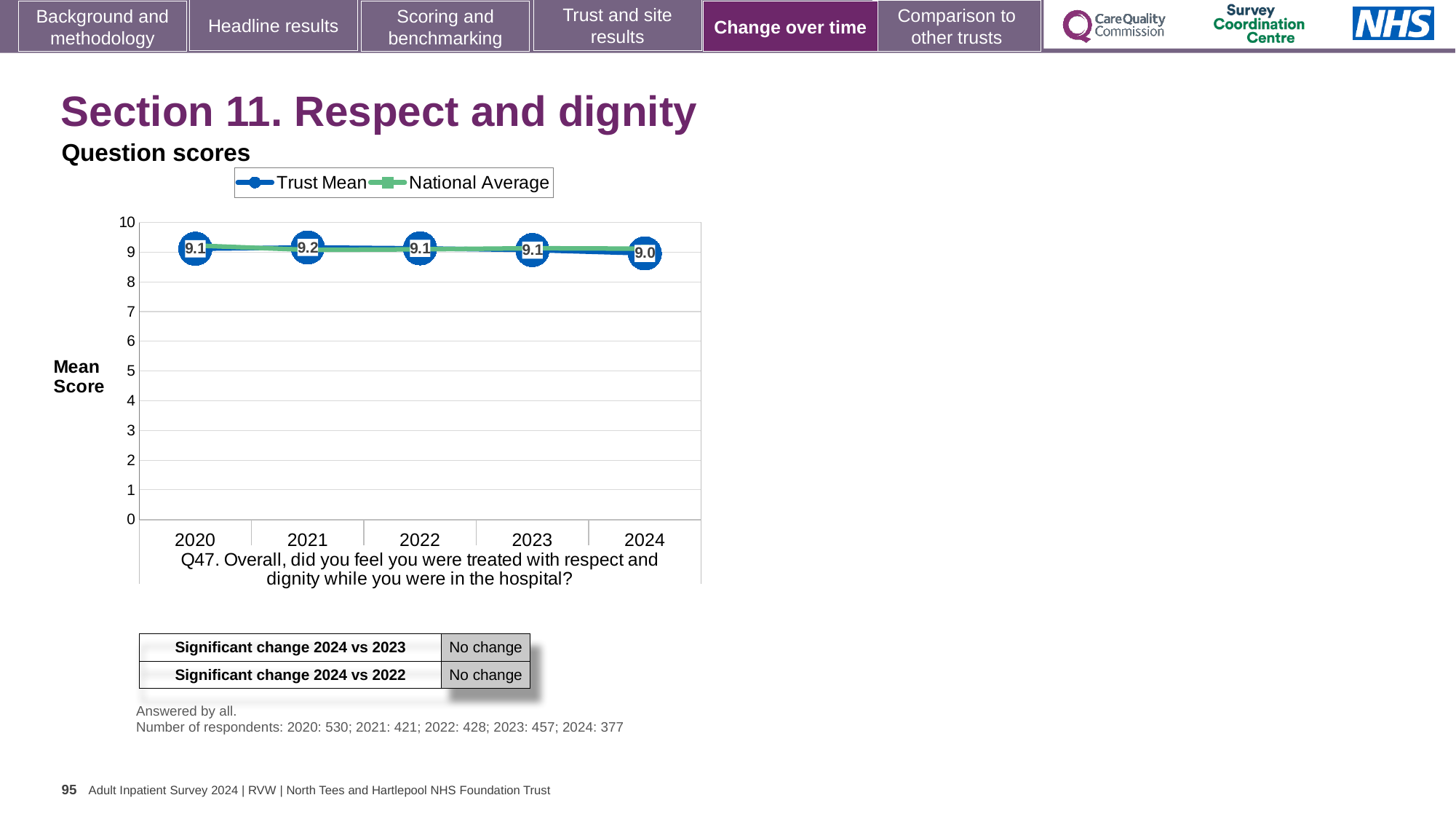
What is the difference between the Trust Mean score in 2021 and in 2024? 0.2 What kind of chart is shown on the slide? line chart What is the Trust Mean score for 2021? 9.2 In which year is the Trust Mean score lowest? 2024 What is the Trust Mean score for 2024? 9.0 Is the Trust Mean score for 2023 greater or less than 8? greater How many series does the legend list? 2 How many years are plotted on the x axis? 5 Which year has the larger Trust Mean score, 2021 or 2024? 2021 What are the two series named in the legend? Trust Mean and National Average In which year is the Trust Mean score highest? 2021 What is the Trust Mean score for 2020? 9.1